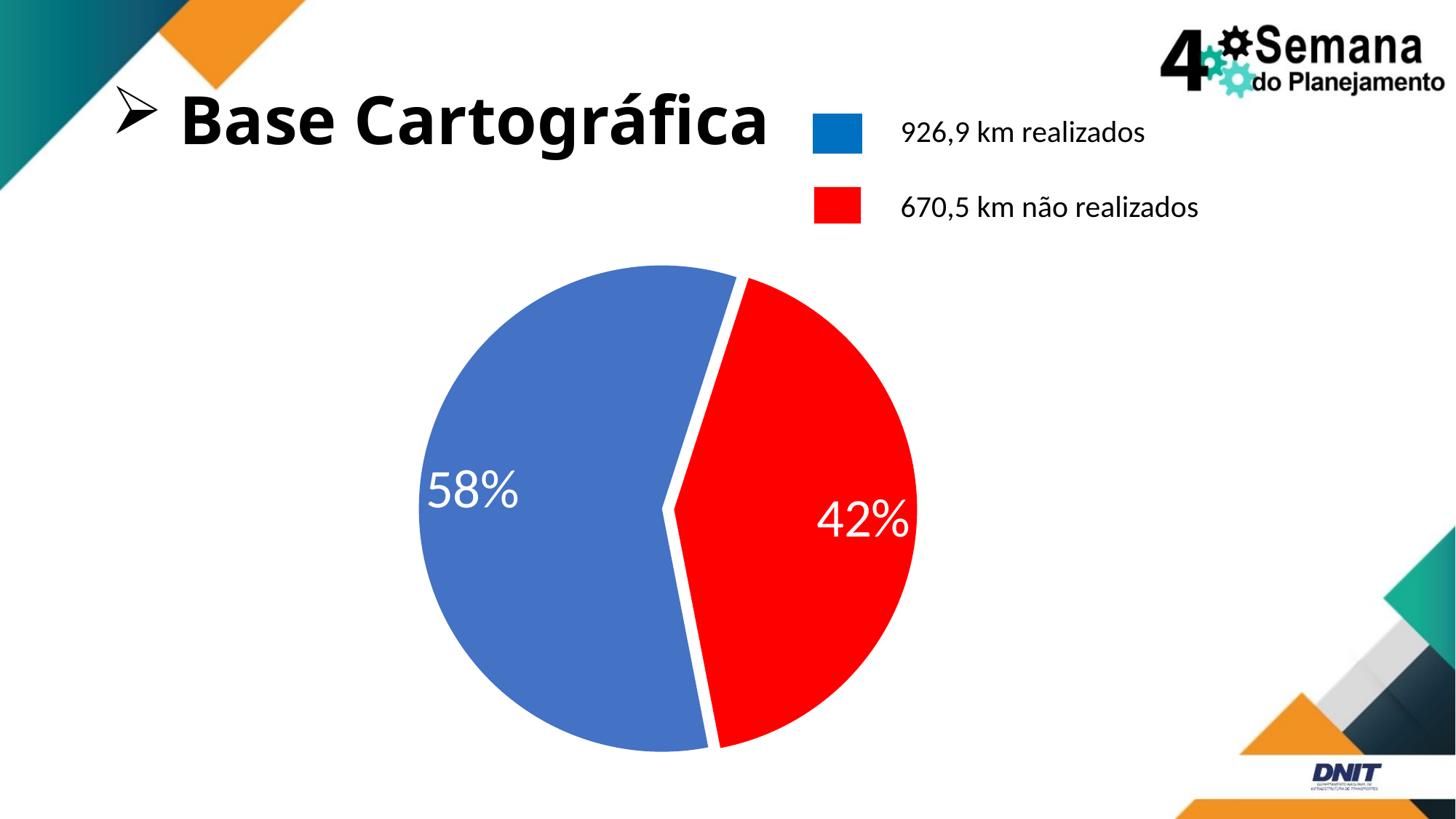
Which slice is larger, realizados or não realizados? realizados How many km are listed as não realizados in the legend? 670,5 km Which category has the smallest share of the pie? não realizados What is the difference in percentage points between the realizados and não realizados slices? 16% What is the title of the slide containing the pie chart? Base Cartográfica How many slices does the pie chart have? 2 How many km are listed as realizados in the legend? 926,9 km What share of the pie does the red slice (não realizados) represent? 42% What kind of chart is shown on the slide? pie chart Is the share for realizados greater or less than 50%? greater What colour is the slice representing não realizados? red What share of the pie does the blue slice (realizados) represent? 58%